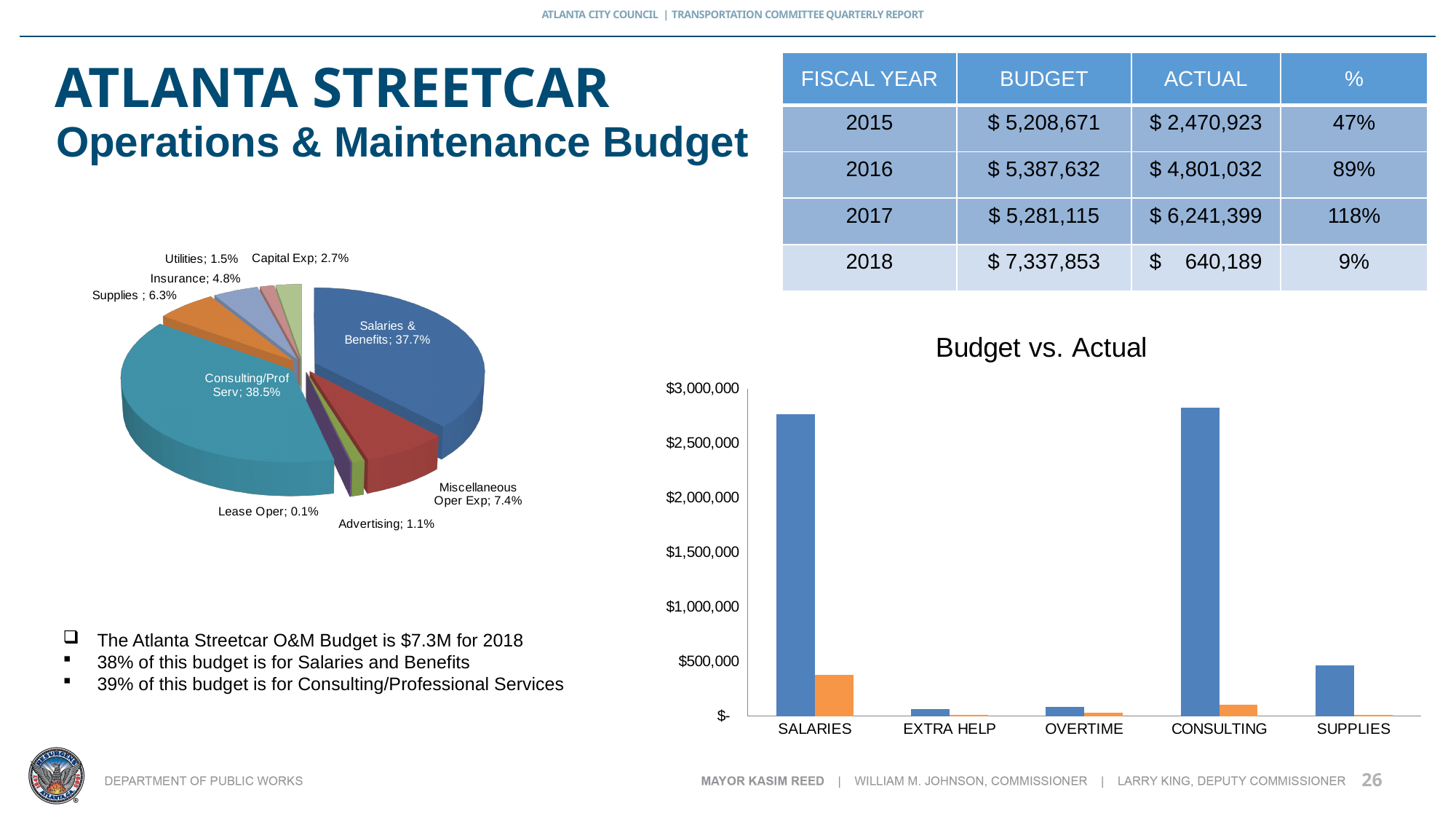
In the pie chart, which category has the smallest share? Lease Oper What type of chart is the 'Budget vs. Actual' chart? bar chart In the 'Budget vs. Actual' chart, is the blue bar for SALARIES greater or less than $2,500,000? greater In the pie chart, what share is shown for Consulting/Prof Serv? 38.5% In the pie chart, what share is shown for Miscellaneous Oper Exp? 7.4% In the pie chart, which category has the largest share? Consulting/Prof Serv In the 'Budget vs. Actual' chart, which blue bar is the lowest? EXTRA HELP What type of chart is the chart on the left side of the slide? pie chart In the pie chart, what share is shown for Salaries & Benefits? 37.7% In the 'Budget vs. Actual' chart, how many categories are shown on the x axis? 5 In the pie chart, what is the difference in percentage points between Consulting/Prof Serv and Salaries & Benefits? 0.8 In the pie chart, how many slices are there? 9